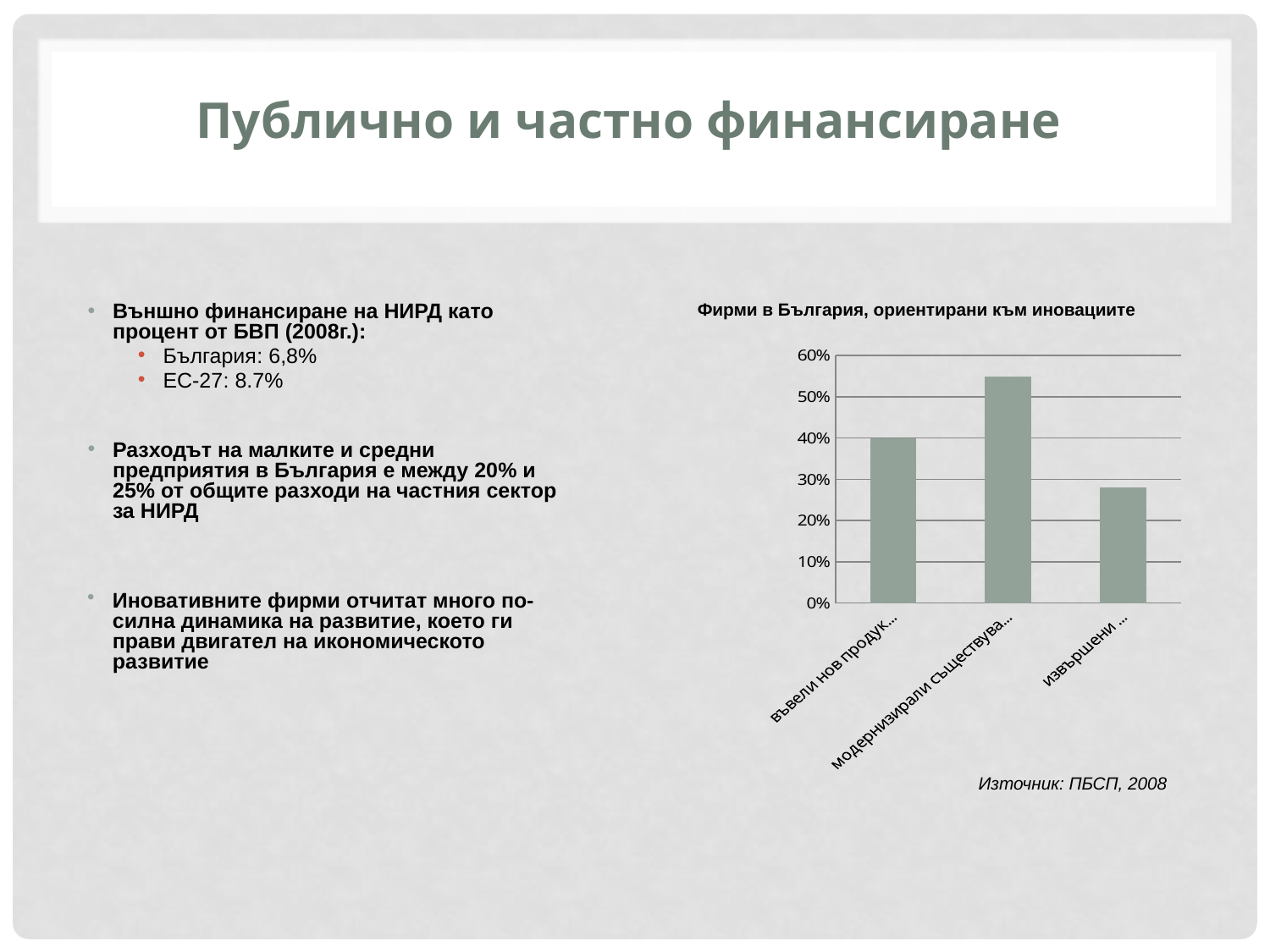
Is the value for the first bar (въвели нов продук...) greater or less than 30%? greater Is the value for the first bar (въвели нов продук...) greater or less than 50%? less What is the highest value shown on the chart's vertical axis? 60% What is the title of the chart? Фирми в България, ориентирани към иновациите Which category has the lowest bar in the chart? извършени ... (the third bar) Is the value for the third bar (извършени ...) greater or less than 30%? less How many bars does the chart show? 3 What kind of chart is shown on the slide? bar chart Which category has the highest bar in the chart? модернизирали съществува... (the second bar) Which is larger: the first bar (въвели нов продук...) or the third bar (извършени ...)? the first bar (въвели нов продук...)